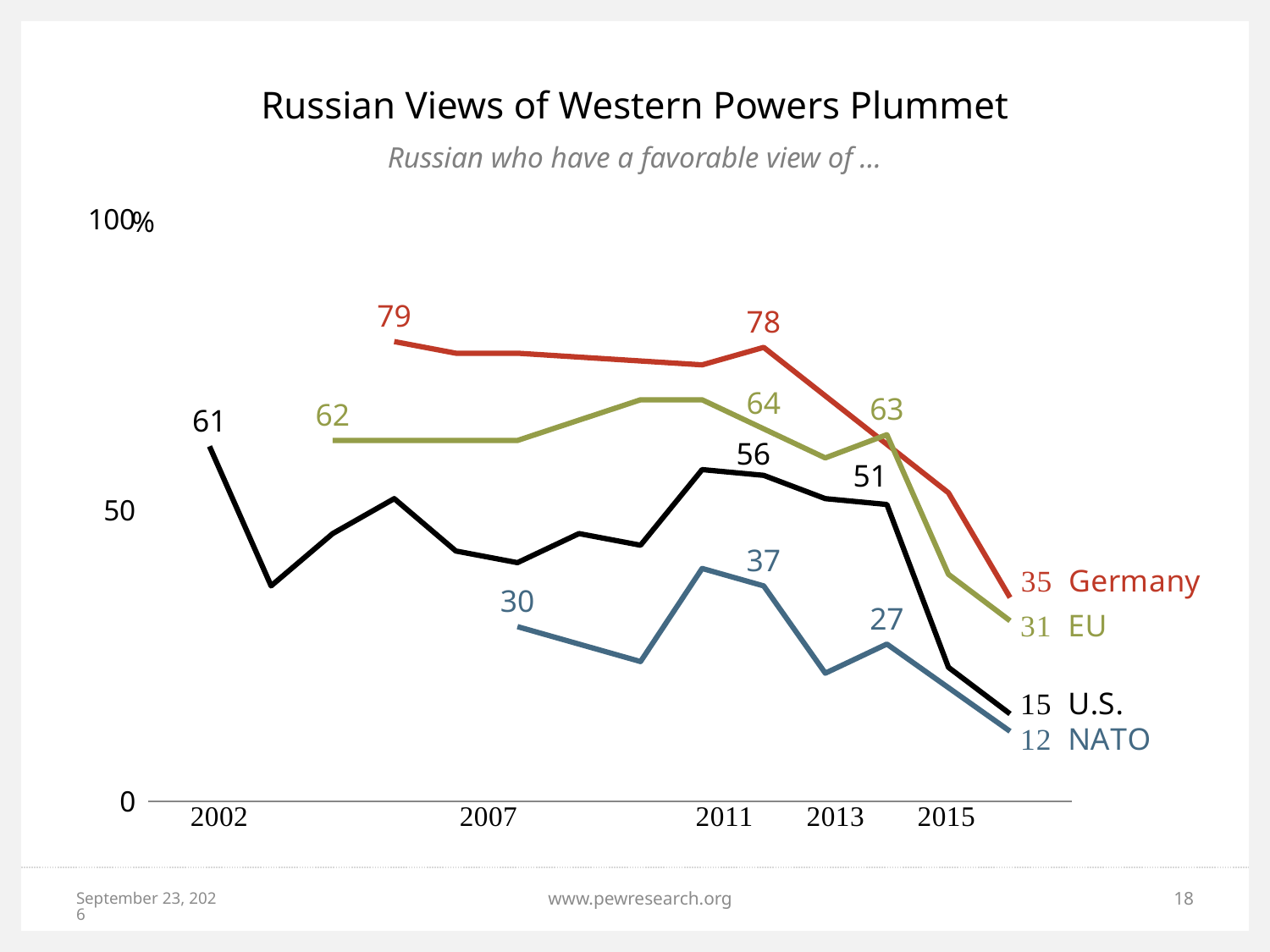
Which series has the highest value at the right end of the chart? Germany What is the final labeled value for NATO at the right end of the chart? 12 What is the final labeled value for the U.S. at the right end of the chart? 15 What kind of chart is shown on the slide? line chart Which series has the lowest value at the right end of the chart? NATO What is the final labeled value for Germany at the right end of the chart? 35 What is the final labeled value for the EU at the right end of the chart? 31 What is the labeled value for the U.S. in 2002? 61 How many series (lines) are plotted on the chart? 4 Does the U.S. line rise or fall between 2013 and the end of the chart? fall What is the difference between the final values for Germany (35) and the EU (31)? 4 What is the title of the chart? Russian Views of Western Powers Plummet